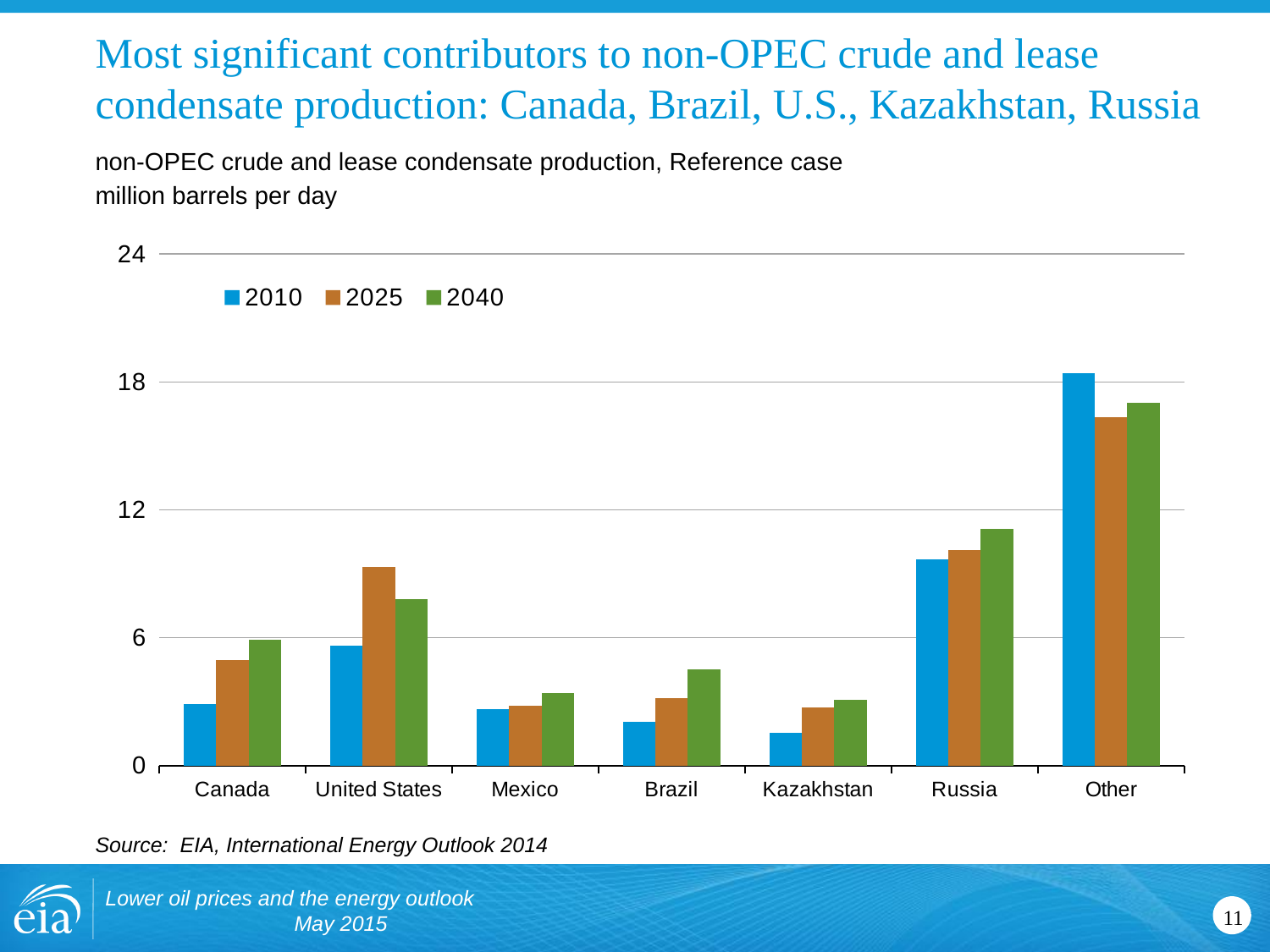
How many categories are shown on the x axis? 7 For United States, which is larger, the 2025 value or the 2040 value? 2025 What colour represents the 2040 series in the legend? green Which category has the lowest 2010 value? Kazakhstan Is the 2010 value for Kazakhstan greater or less than 6? less Is the 2025 value for United States greater or less than 6? greater How many series does the legend list? 3 Do the values for Russia rise or fall from 2010 to 2025 to 2040? rise What kind of chart is shown on the slide? bar chart Is the 2010 value for Other greater or less than 12? greater Which category has the highest 2010 value? Other Which is larger, the 2040 value for Russia or the 2040 value for Canada? Russia